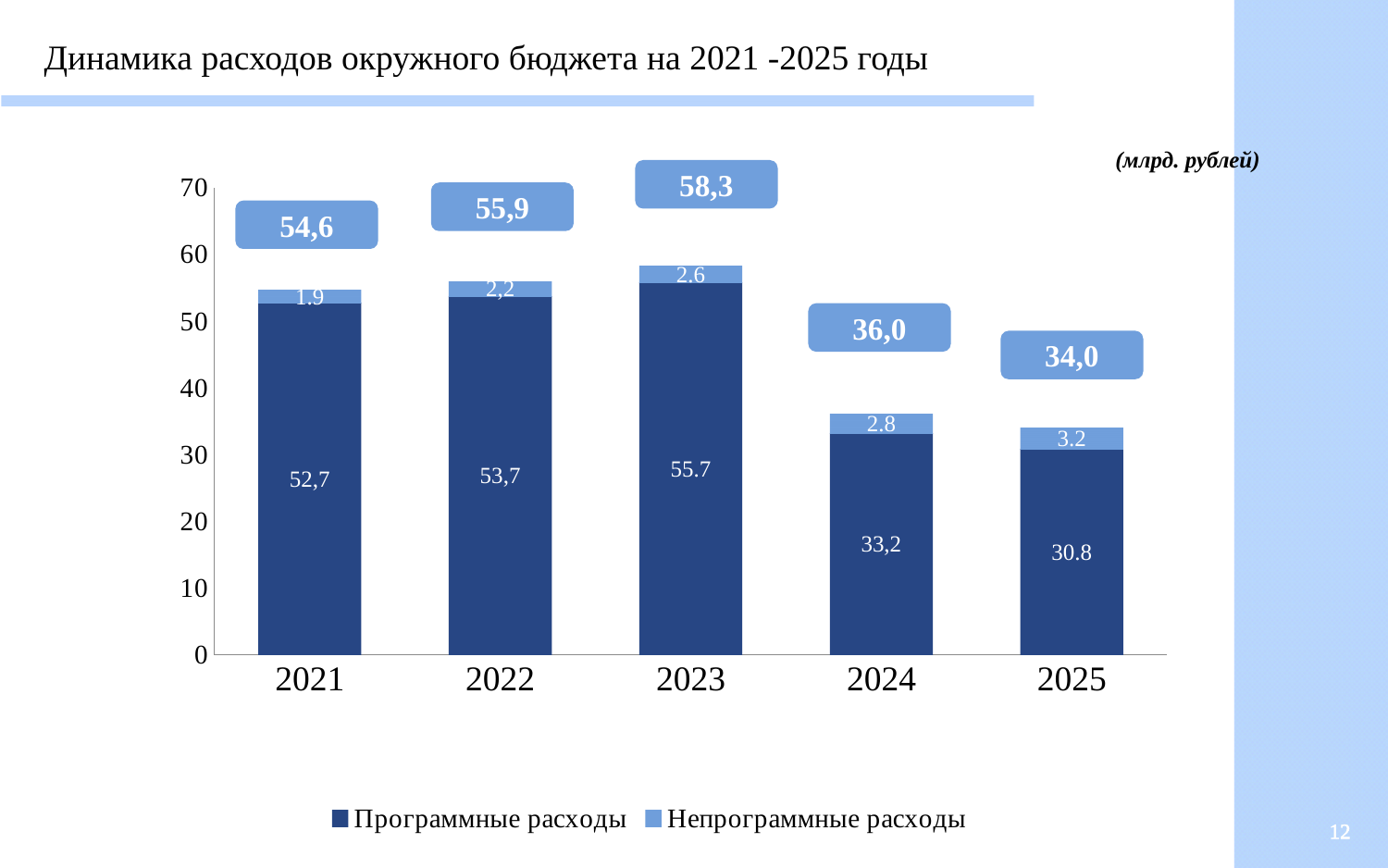
What is the value of Программные расходы for 2025? 30.8 What is the value of Программные расходы for 2021? 52,7 How many years are shown on the x axis of the chart? 5 What is the value of Непрограммные расходы for 2023? 2.6 How many series does the legend list? 2 Which year has the highest total expenditure? 2023 Which year has the larger value of Программные расходы, 2022 or 2024? 2022 Is the total for 2024 greater or less than 40? less Which year has the lowest total expenditure? 2025 What kind of chart is shown on the slide? Stacked bar chart What is the total expenditure shown above the bar for 2023? 58,3 What unit is stated for the values in the chart? млрд. рублей